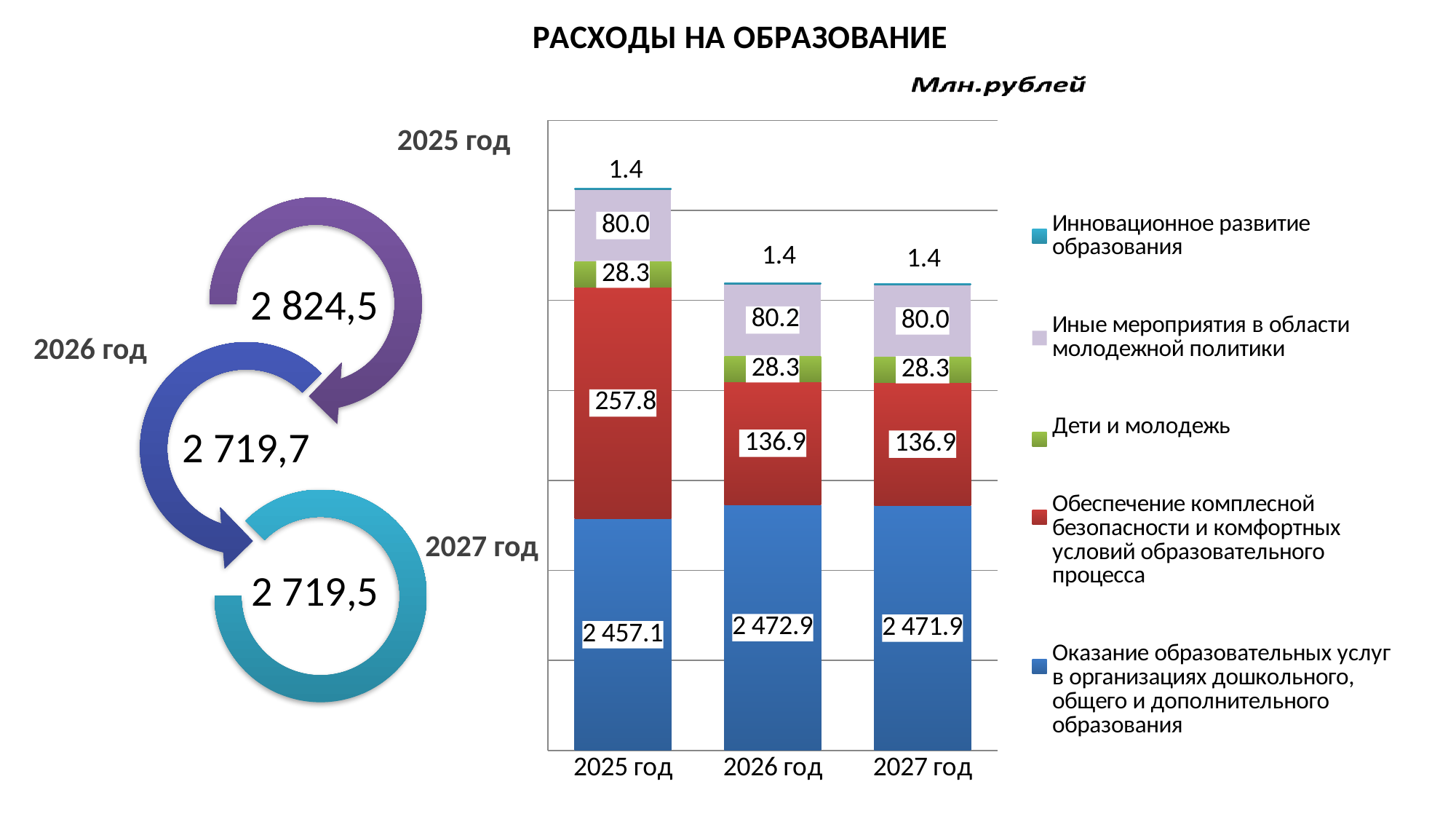
What is the value for «Дети и молодежь» in 2026 год? 28.3 In which year is the value for «Обеспечение комплесной безопасности и комфортных условий образовательного процесса» highest? 2025 год Which year has the larger value for «Иные мероприятия в области молодежной политики», 2025 год or 2026 год? 2026 год How many series does the chart legend list? 5 How many years (categories) are shown on the x axis of the chart? 3 What is the value for «Иные мероприятия в области молодежной политики» in 2027 год? 80.0 What kind of chart is shown on the slide? Stacked bar chart What is the difference between the 2025 год and 2026 год values for «Обеспечение комплесной безопасности и комфортных условий образовательного процесса»? 120.9 What is the value for «Оказание образовательных услуг в организациях дошкольного, общего и дополнительного образования» in 2026 год? 2 472.9 By how much does the value for «Оказание образовательных услуг в организациях дошкольного, общего и дополнительного образования» in 2026 год exceed that in 2025 год? 15.8 What is the value for «Инновационное развитие образования» in 2027 год? 1.4 What is the value for «Обеспечение комплесной безопасности и комфортных условий образовательного процесса» in 2025 год? 257.8